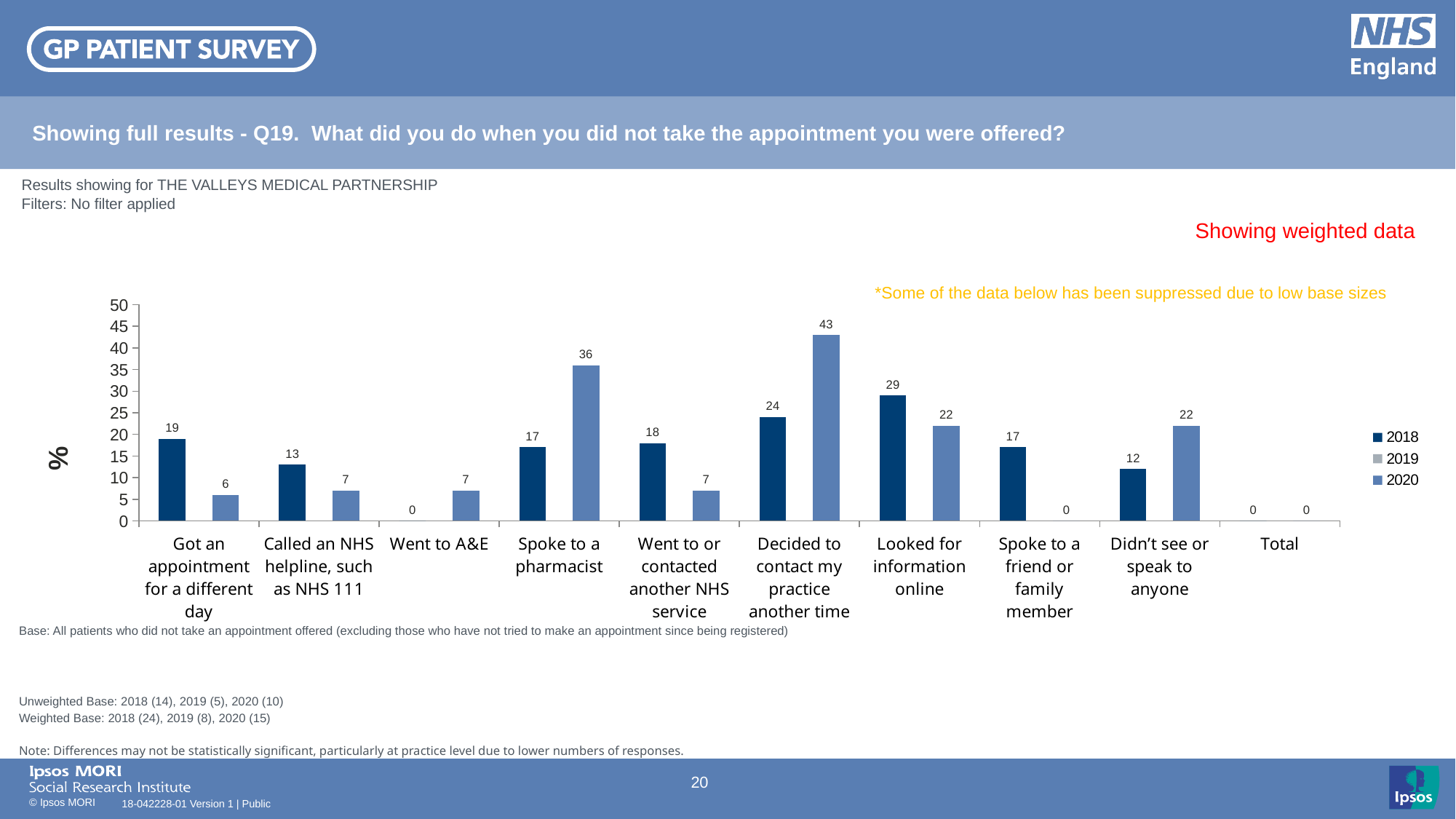
What is the 2020 value for 'Went to A&E'? 7 Which category has the highest 2020 value? Decided to contact my practice another time What kind of chart is shown on the slide? Bar chart What is the 2018 value for 'Looked for information online'? 29 How many series does the legend list? 3 What is the 2020 value for 'Spoke to a pharmacist'? 36 What is the difference between the 2018 and 2020 values for 'Got an appointment for a different day'? 13 What is the label on the vertical axis of the chart? % What is the difference between the 2020 and 2018 values for 'Decided to contact my practice another time'? 19 Which is larger for 'Went to or contacted another NHS service': the 2018 value or the 2020 value? 2018 Which category has the highest 2018 value? Looked for information online Which is larger for 'Didn't see or speak to anyone': the 2018 value or the 2020 value? 2020